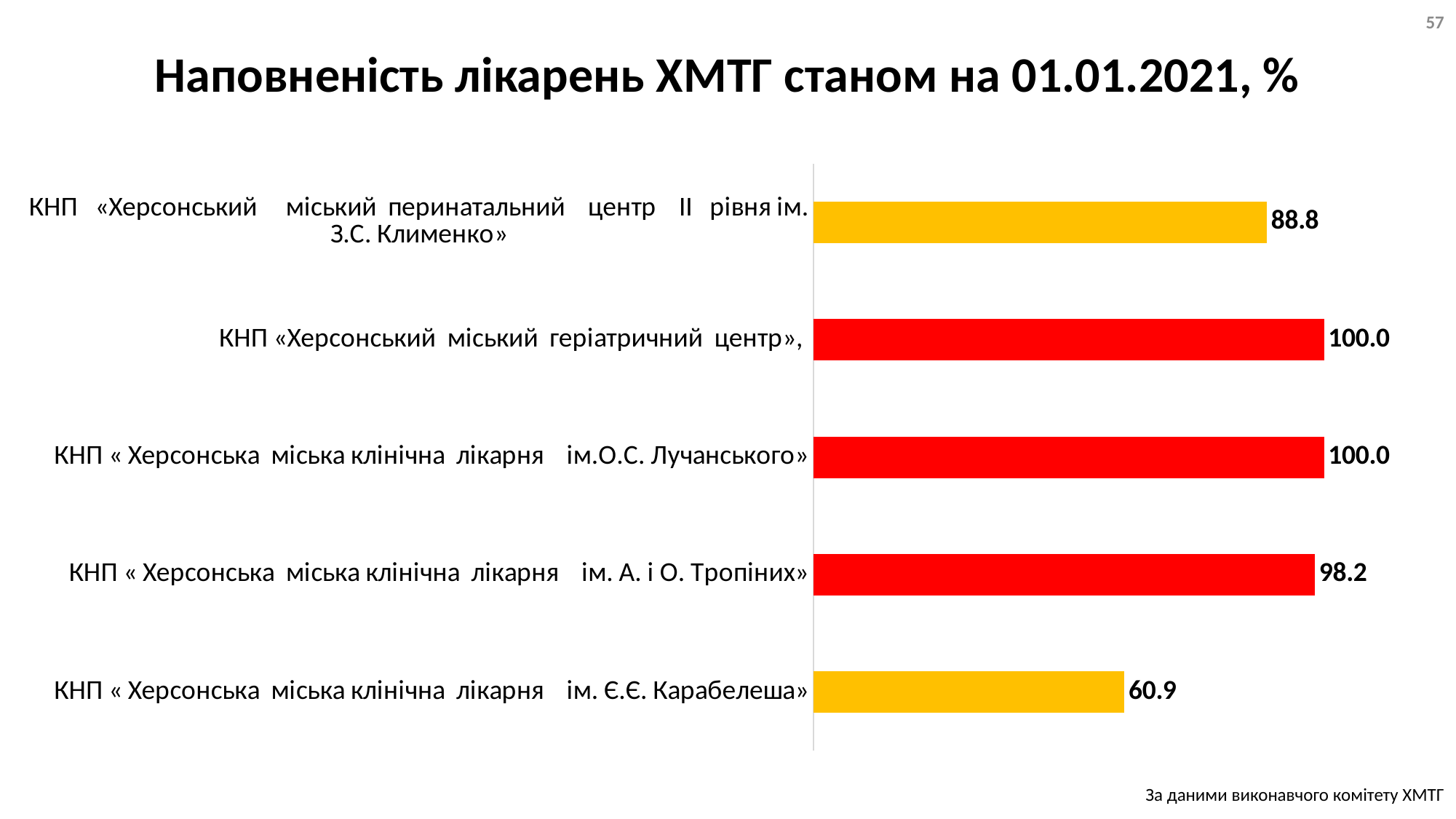
Which hospital has the lowest value on the chart? КНП «Херсонська міська клінічна лікарня ім. Є.Є. Карабелеша» What is the difference between the values for КНП «Херсонська міська клінічна лікарня ім.О.С. Лучанського» and КНП «Херсонська міська клінічна лікарня ім. А. і О. Тропіних»? 1.8 What is the value for КНП «Херсонська міська клінічна лікарня ім. А. і О. Тропіних»? 98.2 What is the title of the chart? Наповненість лікарень ХМТГ станом на 01.01.2021, % How many hospitals are shown on the chart? 5 What colour are the bars for the hospitals with a value of 100.0? Red What is the difference between the values for КНП «Херсонський міський перинатальний центр ІІ рівня ім. З.С. Клименко» and КНП «Херсонська міська клінічна лікарня ім. Є.Є. Карабелеша»? 27.9 What is the value for КНП «Херсонська міська клінічна лікарня ім. Є.Є. Карабелеша»? 60.9 Which is larger: the value for КНП «Херсонська міська клінічна лікарня ім. А. і О. Тропіних» or the value for КНП «Херсонський міський перинатальний центр ІІ рівня ім. З.С. Клименко»? КНП «Херсонська міська клінічна лікарня ім. А. і О. Тропіних» What is the value for КНП «Херсонський міський геріатричний центр»? 100.0 What is the value for КНП «Херсонський міський перинатальний центр ІІ рівня ім. З.С. Клименко»? 88.8 What kind of chart is shown on the slide? Bar chart